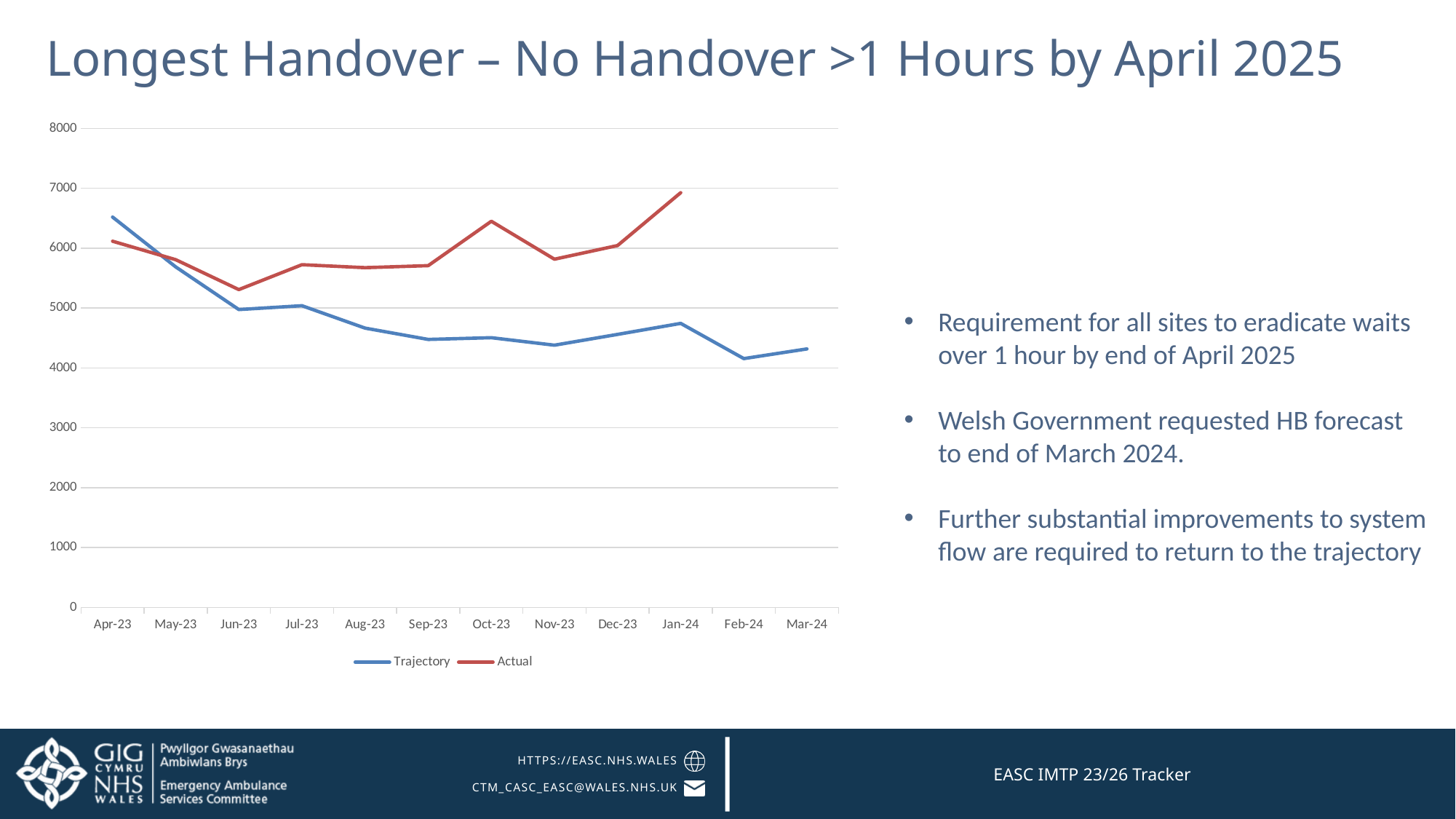
Which month has the highest value for the Actual series? Jan-24 How many months are shown on the x axis? 12 Which month has the highest value for the Trajectory series? Apr-23 Which month has the lowest value for the Trajectory series? Feb-24 What kind of chart is shown on the slide? Line chart Which month has the lowest value for the Actual series? Jun-23 In Jan-24, which series has the larger value, Trajectory or Actual? Actual Which colour is used for the Actual series line? Red Is the Trajectory value for Nov-23 greater or less than 5000? less How many series does the legend list? 2 In Apr-23, which series has the larger value, Trajectory or Actual? Trajectory